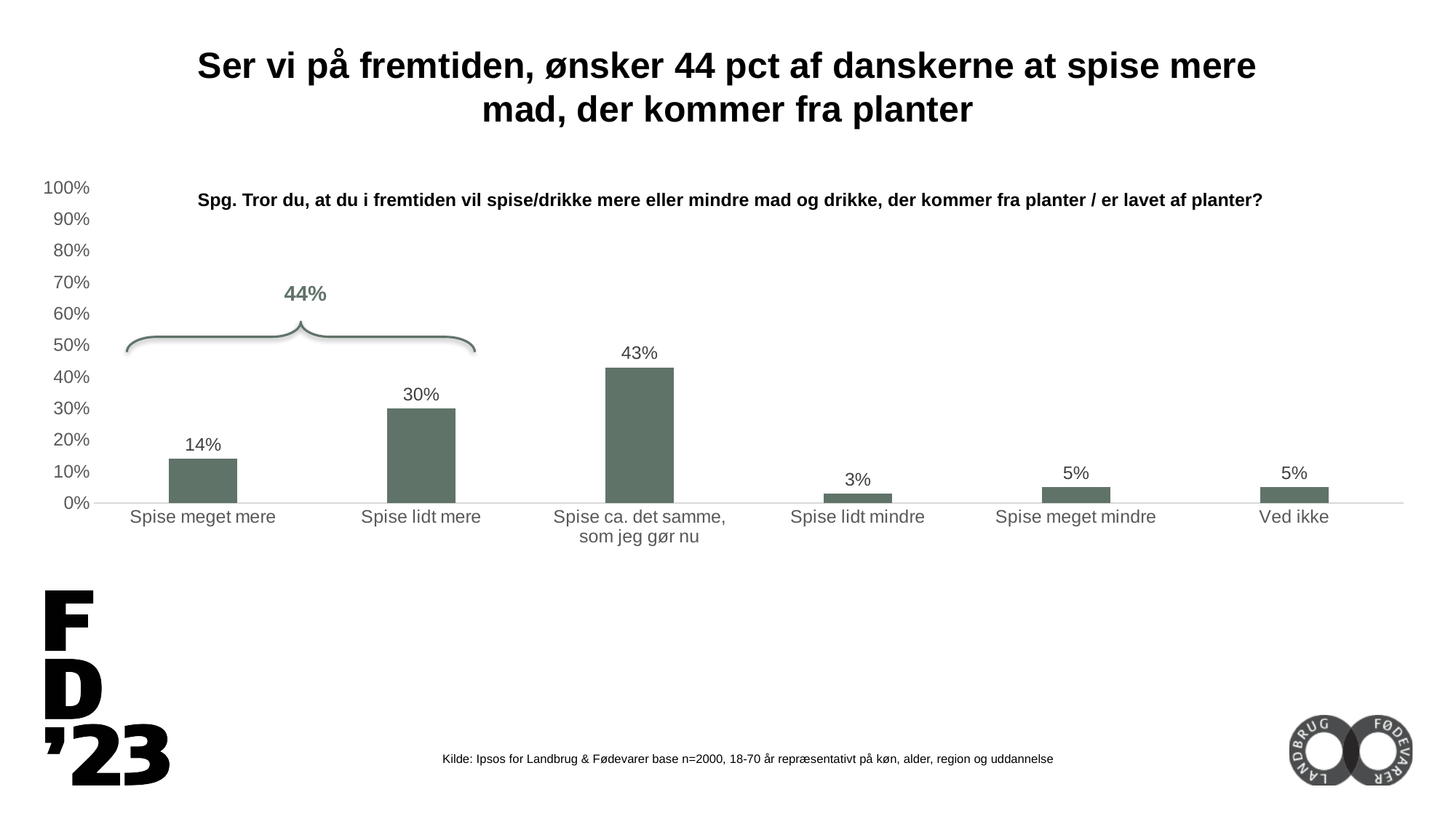
What percentage of respondents answered "Spise lidt mere"? 30% What is the difference in percentage points between "Spise lidt mere" and "Spise meget mere"? 16 percentage points Which category has the highest value in the chart? Spise ca. det samme, som jeg gør nu Is the value for "Spise ca. det samme, som jeg gør nu" greater or less than 40%? greater Which is larger, the value for "Spise meget mere" or the value for "Spise lidt mere"? Spise lidt mere What is the value shown for "Spise ca. det samme, som jeg gør nu"? 43% What percentage is shown for "Ved ikke"? 5% Which category has the lowest value in the chart? Spise lidt mindre What combined percentage does the bracket above the first two bars indicate? 44% How many categories are shown on the x axis of the chart? 6 What kind of chart is shown on the slide? Bar chart What is the difference in percentage points between "Spise ca. det samme, som jeg gør nu" and "Spise lidt mere"? 13 percentage points